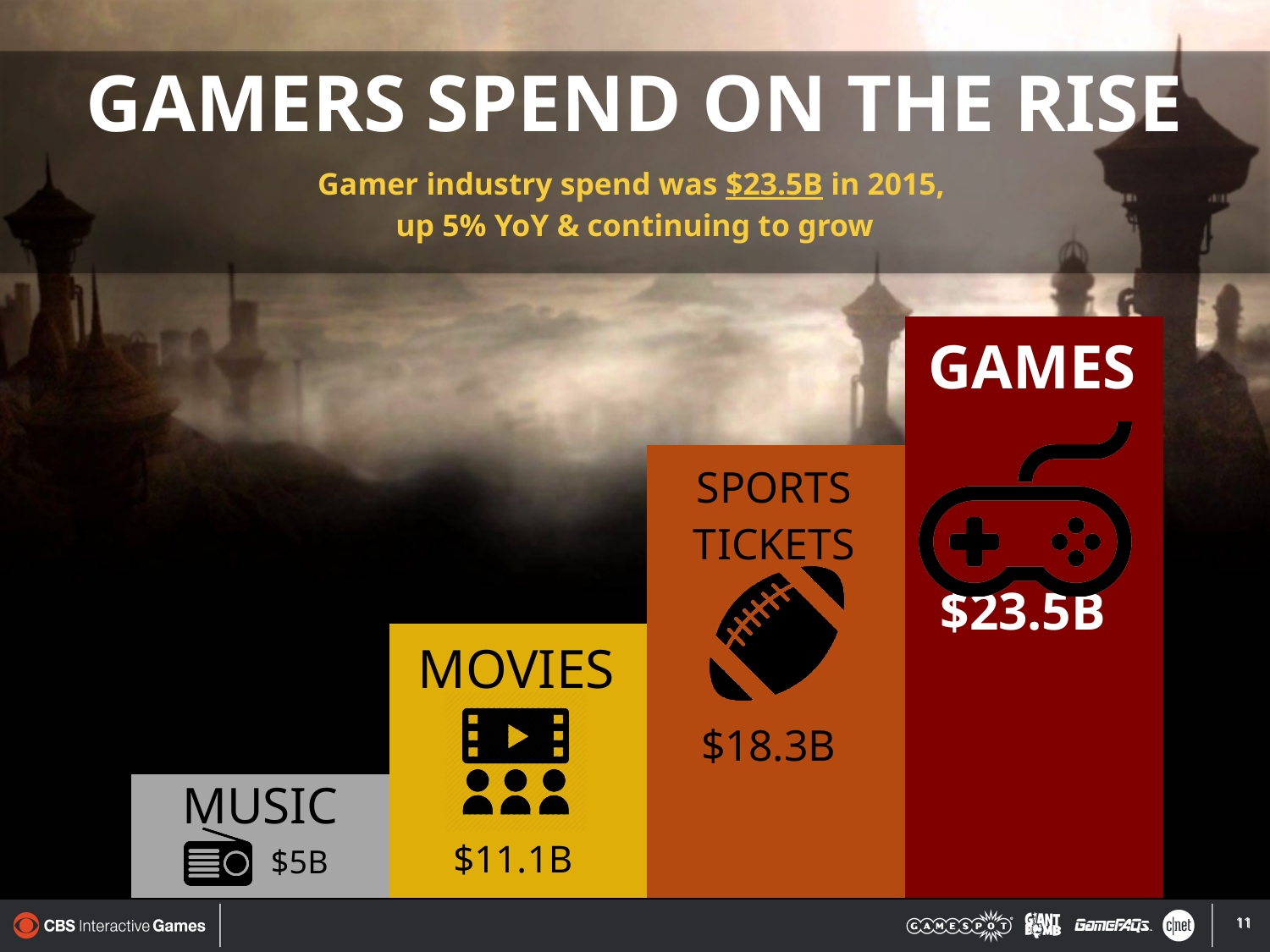
What is the value shown for Movies? $11.1B What is the value shown for Sports Tickets? $18.3B What is the title of the slide containing the chart? GAMERS SPEND ON THE RISE Which is larger, the value for Movies or the value for Sports Tickets? Sports Tickets What is the difference between the Movies value and the Music value? $6.1B Which category has the lowest value? Music What is the difference between the Games value and the Sports Tickets value? $5.2B What is the value shown for Music? $5B Which category has the highest value? Games What is the value shown for Games? $23.5B What kind of chart is shown on the slide? Bar chart How many categories are shown in the chart? 4